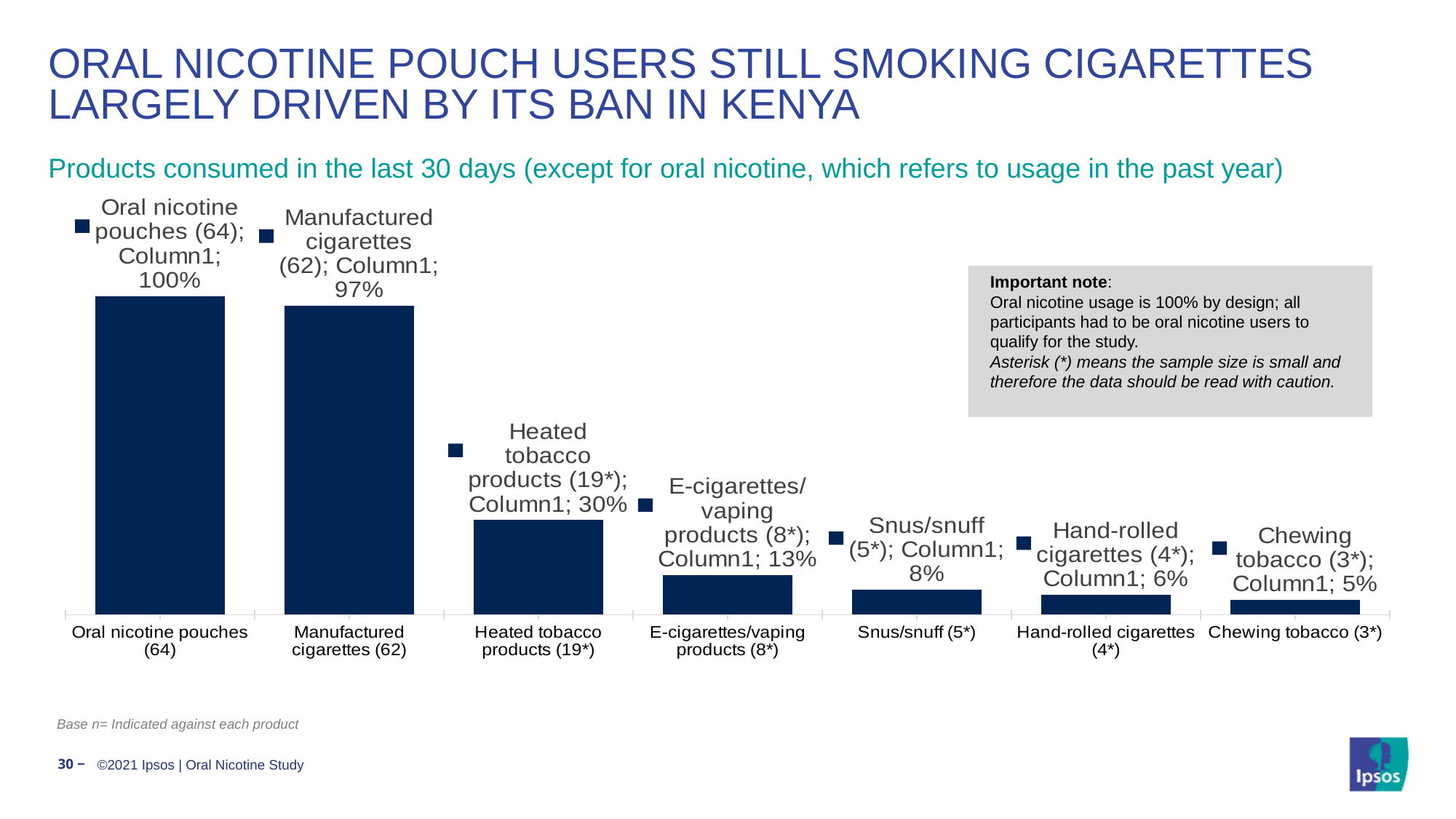
What is the difference in percentage points between Manufactured cigarettes (62) and Heated tobacco products (19*)? 67 What percentage is shown for Heated tobacco products (19*)? 30% Which product has the highest percentage? Oral nicotine pouches (64) How many product categories are shown in the chart? 7 Which product has the lowest percentage? Chewing tobacco (3*) What percentage is shown for E-cigarettes/vaping products (8*)? 13% What percentage is shown for Manufactured cigarettes (62)? 97% What percentage is shown for Snus/snuff (5*)? 8% What kind of chart is shown on the slide? Bar chart What percentage is shown for Chewing tobacco (3*)? 5% Do the values rise or fall moving from left to right across the chart? Fall Which is larger, the value for Snus/snuff (5*) or the value for Hand-rolled cigarettes (4*)? Snus/snuff (5*)